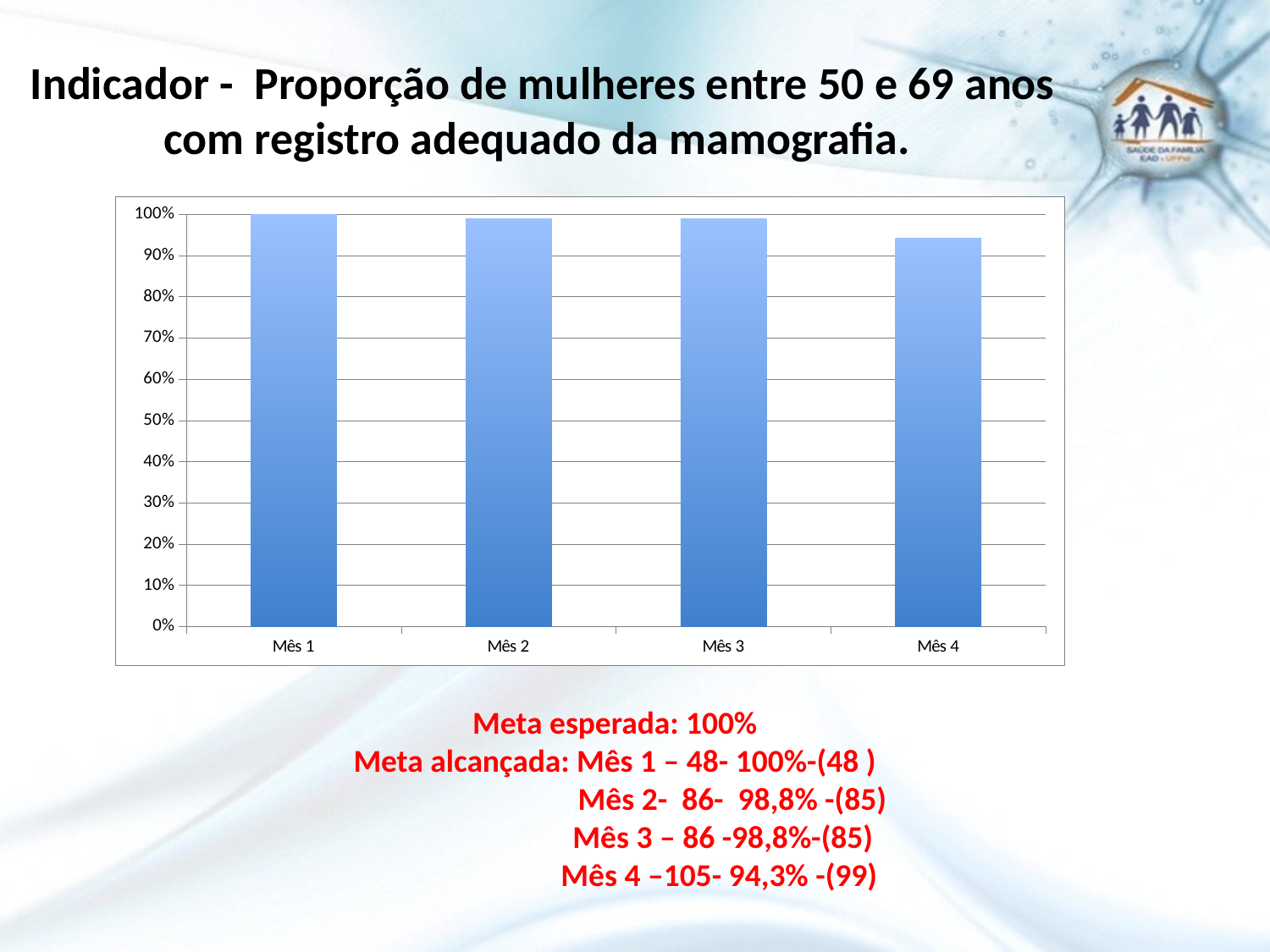
Which is larger, the value for Mês 1 or the value for Mês 4? Mês 1 Which month has the highest bar in the chart? Mês 1 Do the bar values generally rise or fall from Mês 1 to Mês 4? fall What is the expected target (Meta esperada) stated on the slide? 100% According to the slide, what proportion was reached in Mês 2? 98,8% Is the value for Mês 4 greater or less than 90%? greater According to the slide, what proportion was reached in Mês 4? 94,3% Which month has the lowest bar in the chart? Mês 4 How many months (categories) are plotted on the x axis of the chart? 4 What type of chart is shown on the slide? bar chart Is the value for Mês 3 greater or less than 90%? greater What is the value for Mês 1 in the chart? 100%